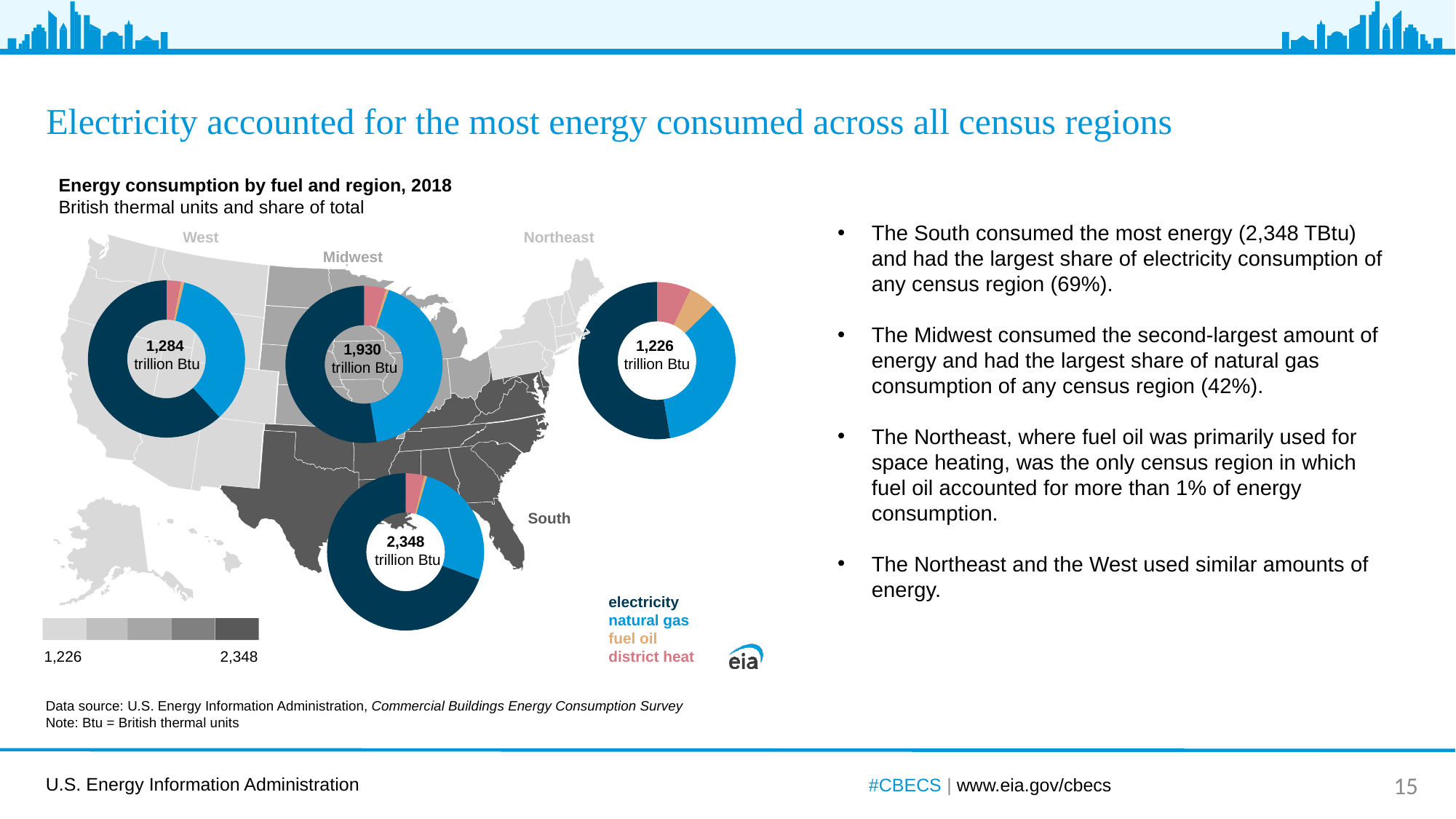
Which census region has the lowest total energy consumption? Northeast What is the total energy consumption shown for the South region? 2,348 trillion Btu How many fuel types does the legend list? 4 What is the difference between the West's and the Northeast's total energy consumption? 58 trillion Btu How much more energy did the South consume than the Midwest, in trillion Btu? 418 trillion Btu How many census regions have a donut chart on the map? 4 What is the total energy consumption shown for the West region? 1,284 trillion Btu In the South donut chart, which fuel accounts for the largest share? electricity What is the total energy consumption shown for the Northeast region? 1,226 trillion Btu What is the total energy consumption shown for the Midwest region? 1,930 trillion Btu Which census region has the highest total energy consumption? South Which region consumed more energy, the West or the Northeast? West